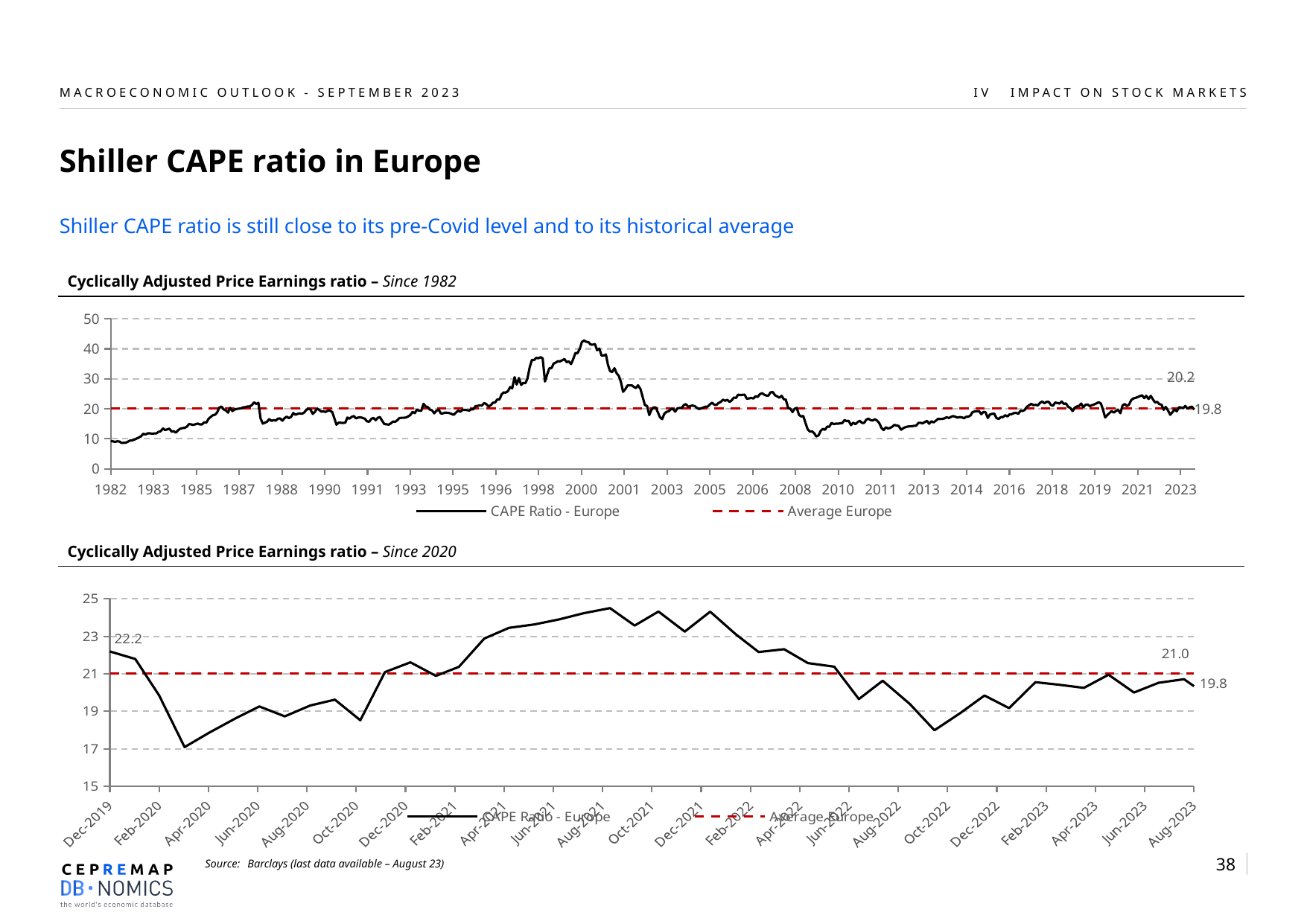
In the 'Since 2020' chart, which is larger: the CAPE Ratio - Europe at Dec-2019 or at Aug-2023? Dec-2019 In the 'Since 2020' chart, does the CAPE Ratio - Europe rise or fall between Dec-2019 and Apr-2020? fall In the 'Since 1982' chart, what kind of chart is shown? line chart In the 'Since 2020' chart, what is the labelled value of the CAPE Ratio - Europe at Dec-2019? 22.2 In the 'Since 2020' chart, what is the difference between the Dec-2019 value (22.2) and the Aug-2023 value (19.8) of the CAPE Ratio - Europe? 2.4 In the 'Since 1982' chart, is the peak of the CAPE Ratio - Europe around 2000 greater or less than 40? greater In the 'Since 1982' chart, what is the labelled value of the Average Europe line? 20.2 In the 'Since 2020' chart, is the CAPE Ratio - Europe at Apr-2020 greater or less than 19? less In the 'Since 1982' chart, what is the latest labelled value of the CAPE Ratio - Europe? 19.8 In the 'Since 1982' chart, how many series does the legend list? 2 In the 'Since 2020' chart, what is the labelled value of the CAPE Ratio - Europe at Aug-2023? 19.8 In the 'Since 2020' chart, what is the labelled value of the Average Europe line? 21.0